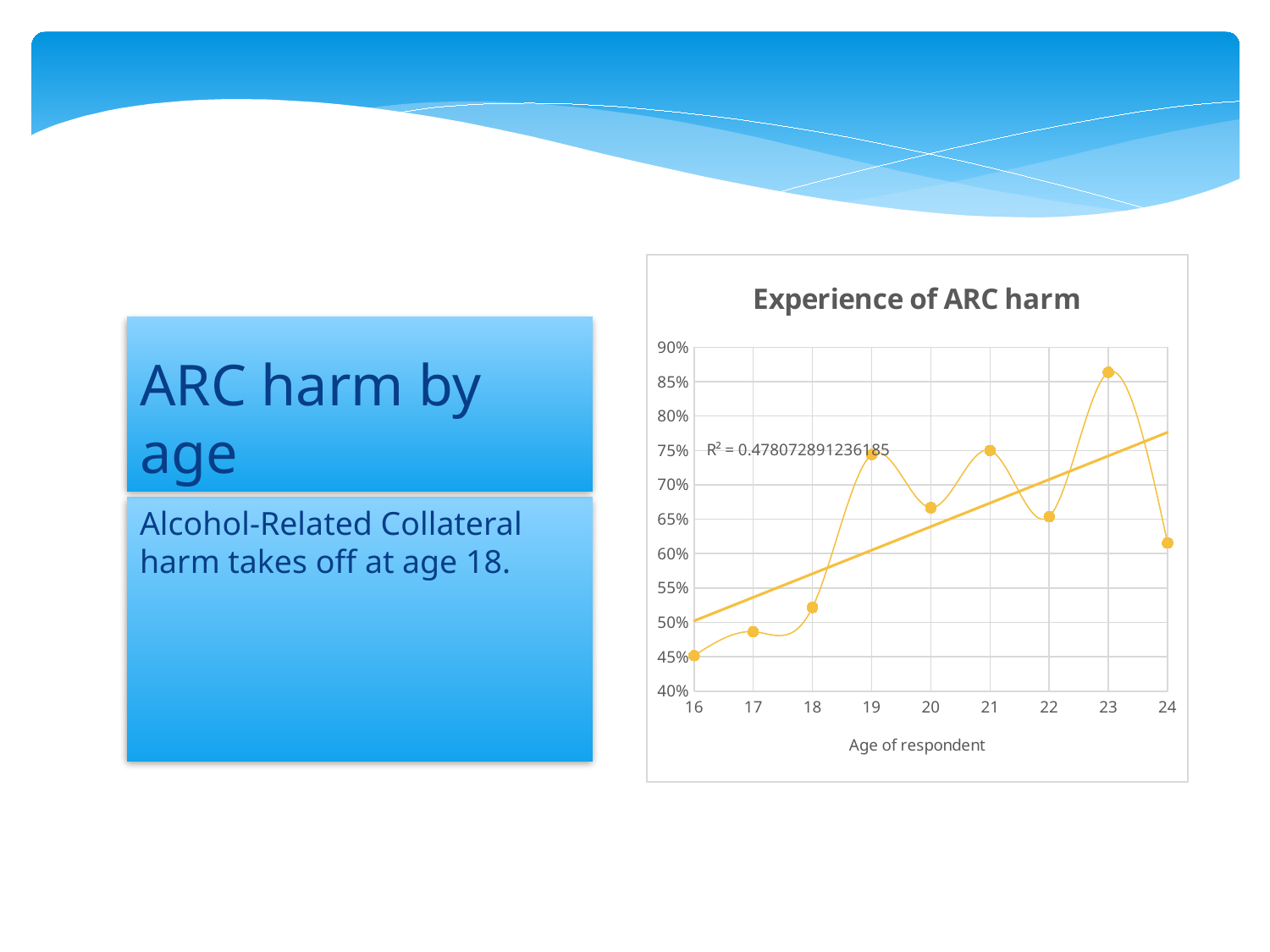
What is the title of the chart? Experience of ARC harm Is the value for age 24 greater or less than 60%? greater What R² value is printed on the chart for the trendline? 0.478072891236185 How many data points are plotted on the chart? 9 At which age is the experience of ARC harm lowest? 16 Which age has the larger value, 18 or 19? 19 What is the label of the x axis? Age of respondent Is the value for age 18 greater or less than 55%? less What kind of chart is shown on the slide? Line chart At which age is the experience of ARC harm highest? 23 Is the value for age 23 greater or less than 85%? greater